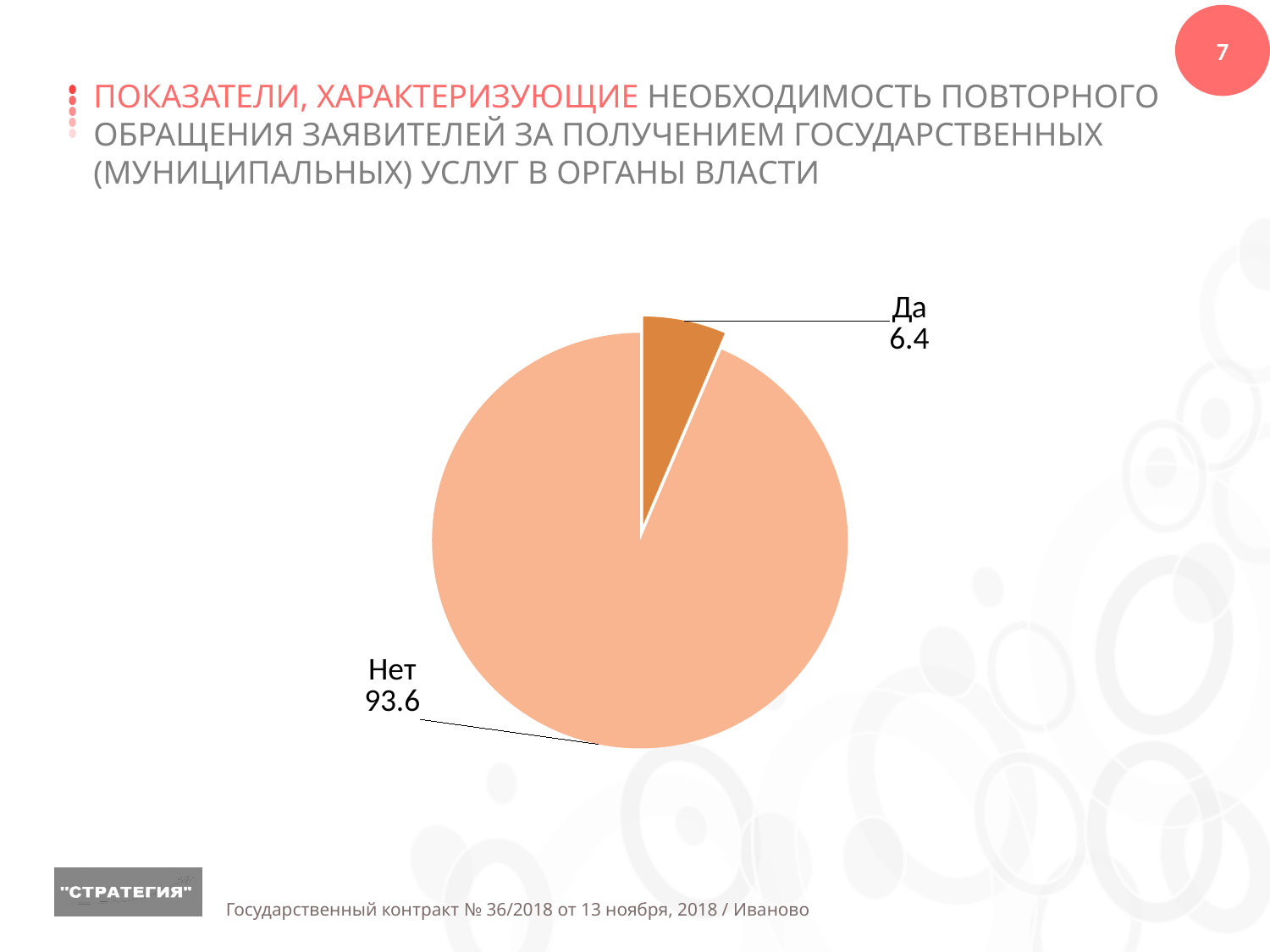
Which slice is the smallest? Да Which is larger, the value for "Да" or the value for "Нет"? Нет Which slice is pulled out (exploded) from the pie? Да What is the total of the two slice values? 100 What is the difference between the "Нет" and "Да" values? 87.2 What colour is the "Да" slice? dark orange What kind of chart is shown on the slide? pie chart What is the value for the "Да" slice? 6.4 What is the value for the "Нет" slice? 93.6 Which slice is the largest? Нет How many slices does the pie chart have? 2